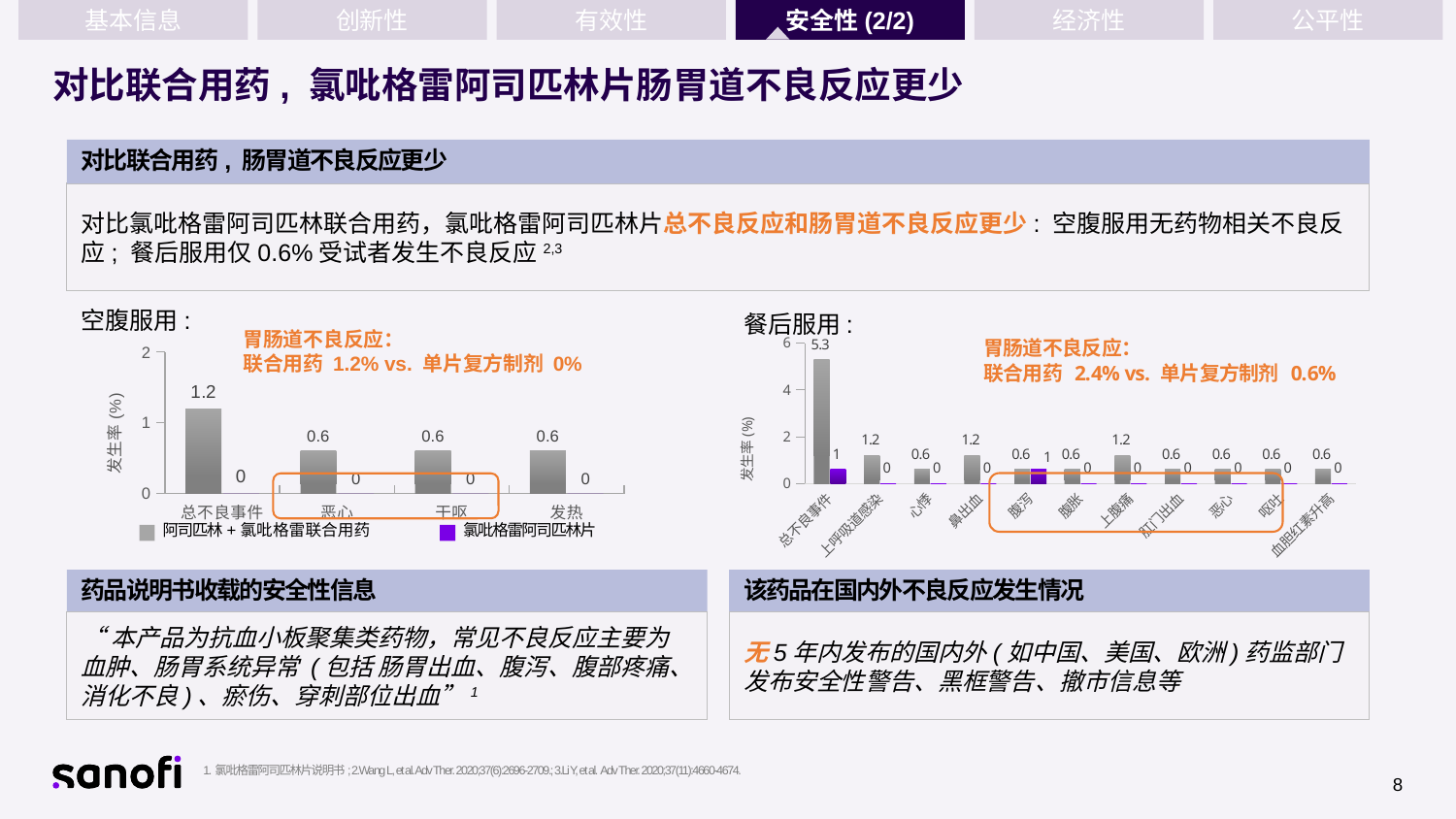
In the 餐后服用 chart on the right, which is larger for 上腹痛: the 阿司匹林 + 氯吡格雷联合用药 value or the 氯吡格雷阿司匹林片 value? 阿司匹林 + 氯吡格雷联合用药 In the 空腹服用 chart on the left, which category has the highest value for the 阿司匹林 + 氯吡格雷联合用药 series? 总不良事件 In the 空腹服用 chart on the left, what is the value for 总不良事件 for the 阿司匹林 + 氯吡格雷联合用药 series? 1.2 In the 空腹服用 chart on the left, what is the value for 恶心 for the 氯吡格雷阿司匹林片 series? 0 In the 空腹服用 chart on the left, how many categories are shown on the x axis? 4 In the 餐后服用 chart on the right, how many categories are shown on the x axis? 11 In the 空腹服用 chart on the left, what is the difference between the 阿司匹林 + 氯吡格雷联合用药 value and the 氯吡格雷阿司匹林片 value for 总不良事件? 1.2 In the 空腹服用 chart on the left, how many series does the legend list? 2 In the 餐后服用 chart on the right, what is the value for 总不良事件 for the 阿司匹林 + 氯吡格雷联合用药 series? 5.3 In the 餐后服用 chart on the right, what is the value for 腹泻 for the 氯吡格雷阿司匹林片 series? 1 What kind of chart is the 餐后服用 chart on the right? bar chart